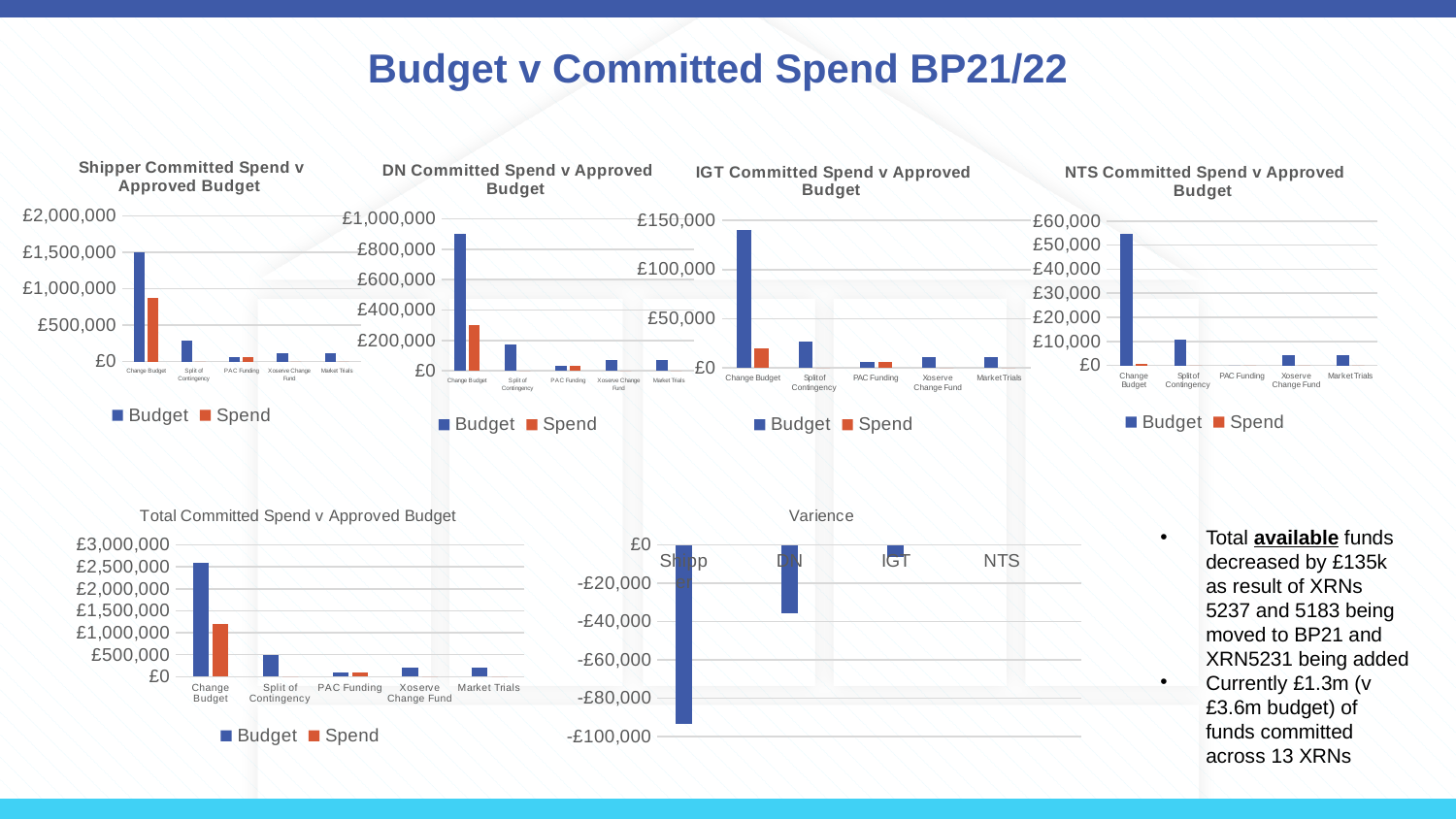
How many series does the legend of the 'Shipper Committed Spend v Approved Budget' chart list? 2 In the 'Shipper Committed Spend v Approved Budget' chart, is the Budget value for Change Budget greater or less than £1,000,000? greater How many categories are shown on the x axis of the 'Total Committed Spend v Approved Budget' chart? 5 In the 'DN Committed Spend v Approved Budget' chart, is the Budget value for Change Budget greater or less than £800,000? greater In the 'Shipper Committed Spend v Approved Budget' chart, is the Spend value for Change Budget greater or less than £1,000,000? less In the 'Shipper Committed Spend v Approved Budget' chart, which category has the highest Budget value? Change Budget In the 'Varience' chart, which category has the lowest value? Shipper What kind of chart is the 'Shipper Committed Spend v Approved Budget' chart? bar chart What are the two legend entries in the 'NTS Committed Spend v Approved Budget' chart? Budget and Spend In the 'Total Committed Spend v Approved Budget' chart, which is larger for Change Budget, the Budget or the Spend? Budget